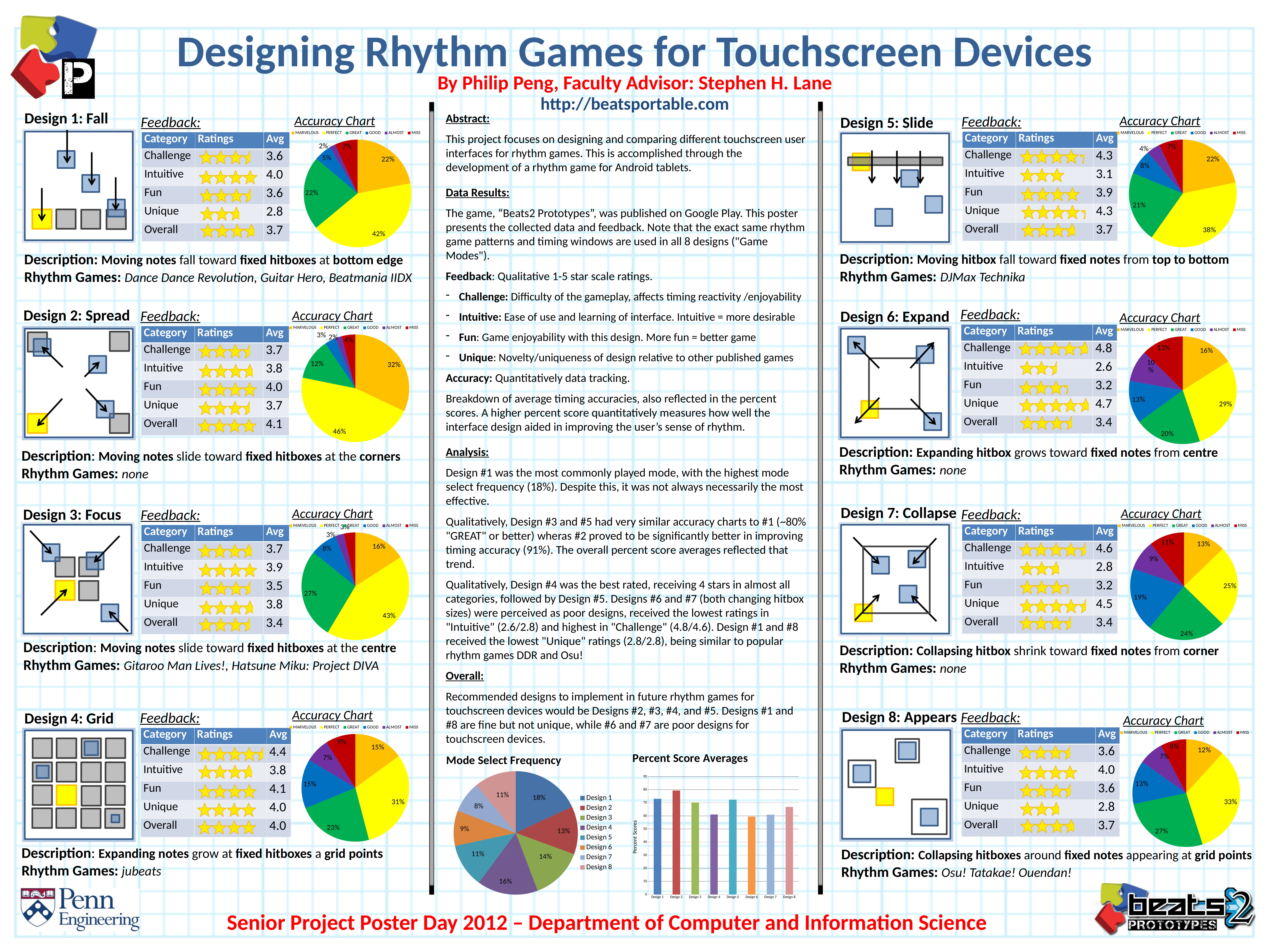
In the Mode Select Frequency pie chart, which design has the smallest share? Design 7 In the Mode Select Frequency pie chart, what percentage is shown for Design 1? 18% In the Design 2: Spread Accuracy Chart, what percentage is shown for the MISS slice (red)? 4% How many categories does the legend of each Accuracy Chart list? 6 What kind of chart is the Percent Score Averages chart? bar chart In the Mode Select Frequency pie chart, how many designs does the legend list? 8 In the Percent Score Averages chart, which design has the highest bar? Design 2 In the Mode Select Frequency pie chart, what is the difference between the shares of Design 1 and Design 2? 5% In the Design 6: Expand Accuracy Chart, what percentage is shown for the PERFECT slice (yellow)? 29% In the Percent Score Averages chart, is the value for Design 4 greater or less than 70? less In the Design 8: Appears Accuracy Chart, which is larger, the GREAT slice (green) or the GOOD slice (blue)? GREAT In the Design 1: Fall Accuracy Chart, what percentage is shown for the largest slice? 42%